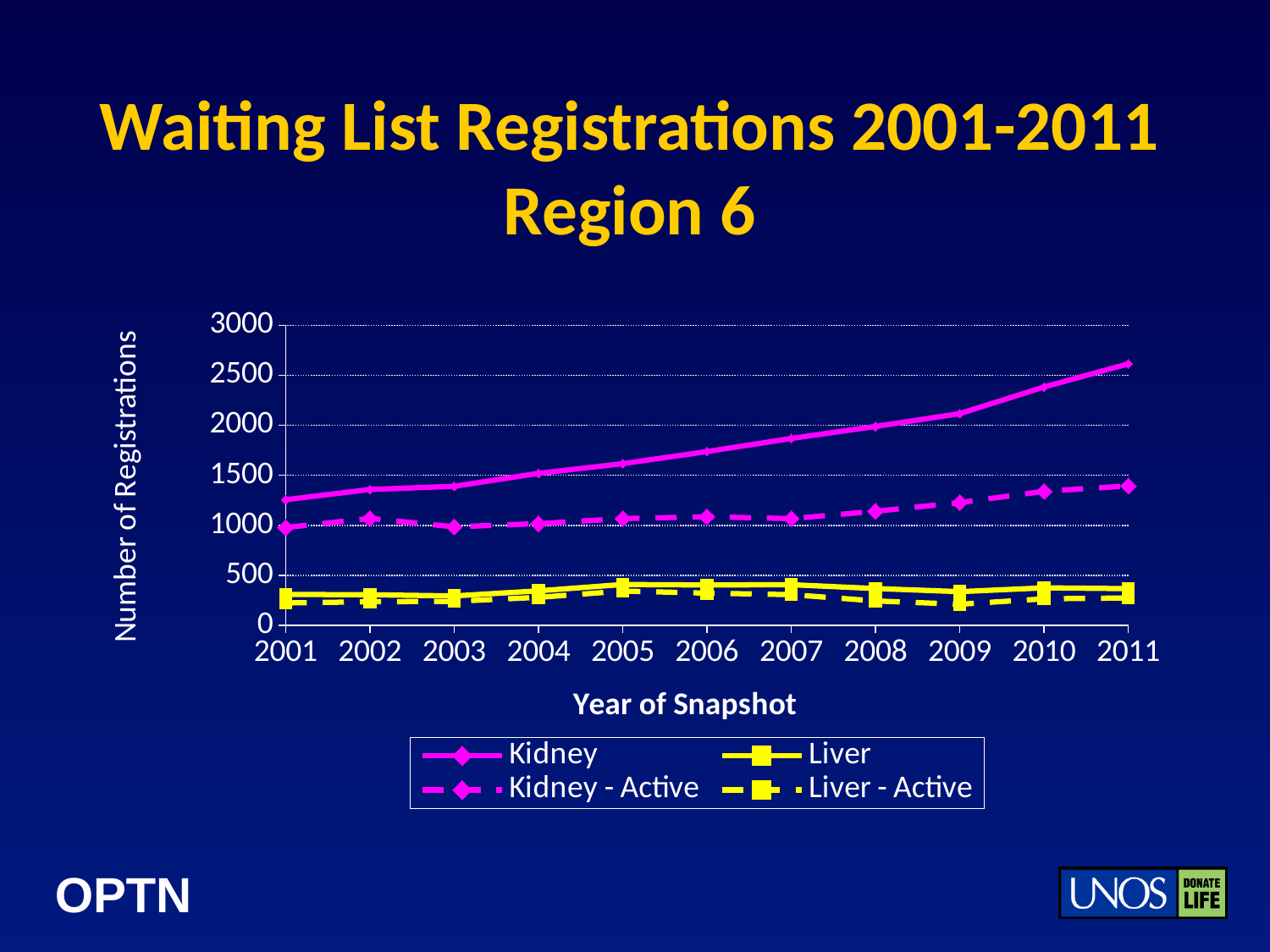
Which series has the larger value in 2011, Kidney or Liver? Kidney What is the label on the y axis? Number of Registrations How many series does the legend list? 4 How many years are plotted along the x axis? 11 Is the value for Kidney in 2009 greater or less than 2000? greater Is the value for Kidney in 2011 greater or less than 2500? greater In which year is the Kidney series at its highest? 2011 What kind of chart is shown on the slide? line chart What is the label on the x axis? Year of Snapshot Does the Kidney series rise or fall from 2001 to 2011? rise Is the value for Kidney - Active in 2011 greater or less than 1500? less